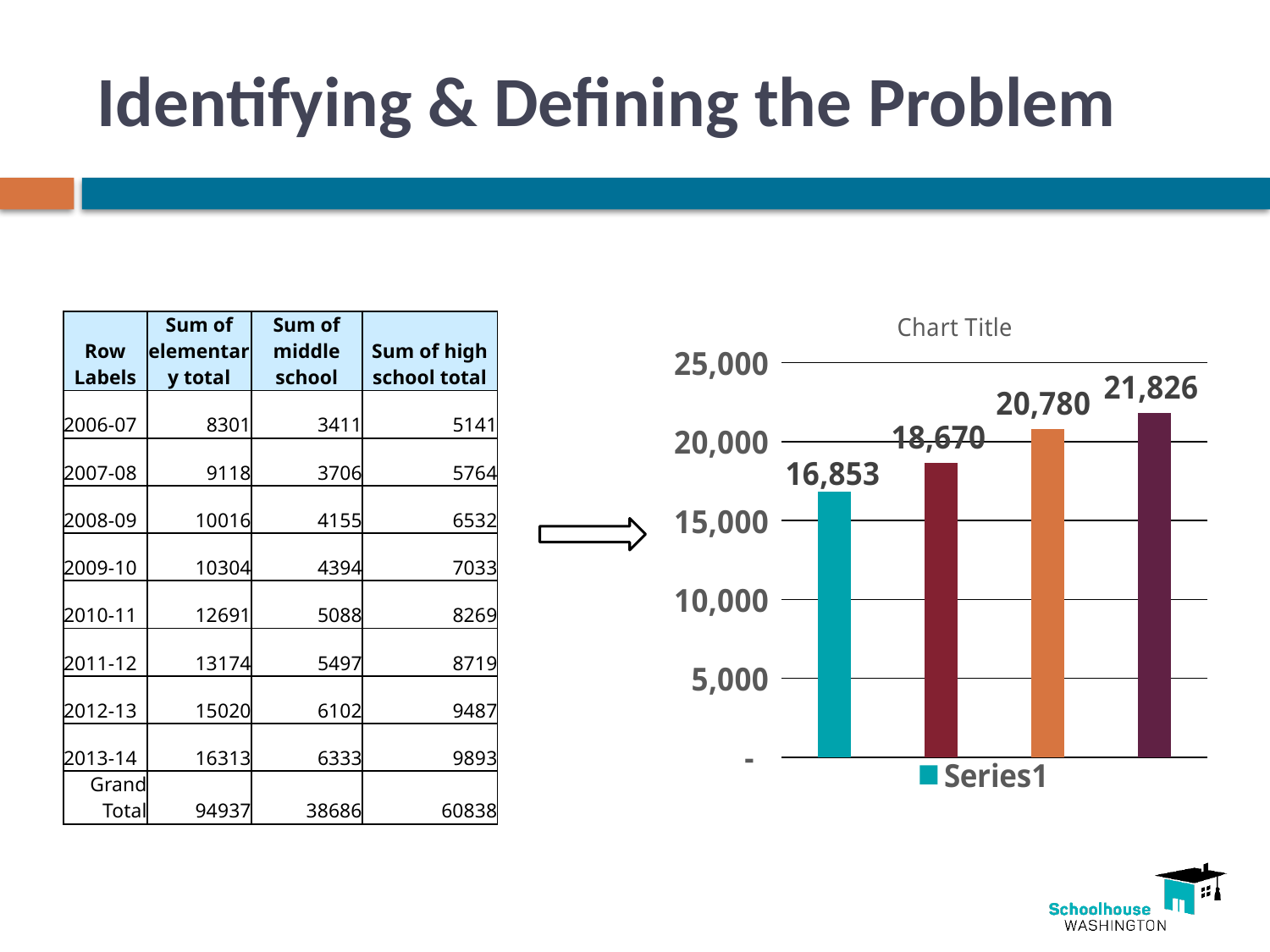
What type of chart is shown on the slide? bar chart What is the value shown on the first (leftmost) bar of the chart? 16,853 How many bars are plotted in the chart? 4 Which bar has the lowest value in the chart? the first (leftmost) bar, 16,853 Which bar has the highest value in the chart? the fourth (rightmost) bar, 21,826 What is the value shown on the third bar of the chart? 20,780 What is the value shown on the second bar of the chart? 18,670 What is the difference between the rightmost bar and the leftmost bar in the chart? 4,973 What is the name of the series shown in the chart legend? Series1 How many series does the chart legend list? 1 What is the value shown on the fourth (rightmost) bar of the chart? 21,826 Do the bar values rise or fall from left to right across the chart? rise